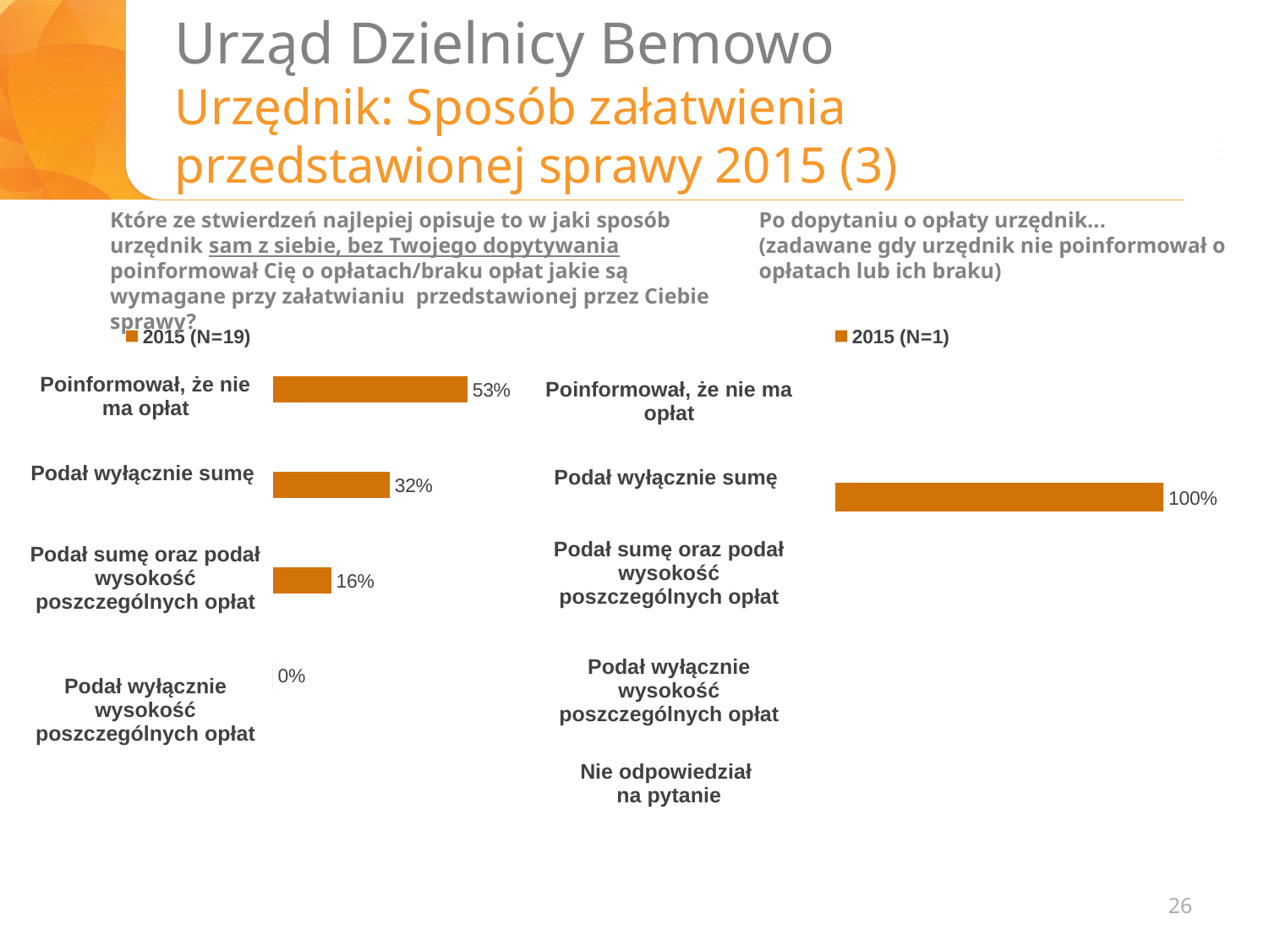
In the left chart (2015, N=19), what percentage is shown for "Podał sumę oraz podał wysokość poszczególnych opłat"? 16% In the left chart (2015, N=19), what percentage is shown for "Podał wyłącznie sumę"? 32% How many categories does the left chart (2015, N=19) show? 4 In the right chart (2015, N=1), what percentage is shown for "Podał wyłącznie sumę"? 100% In the left chart (2015, N=19), which category has the highest value? Poinformował, że nie ma opłat In the left chart (2015, N=19), what is the difference between "Poinformował, że nie ma opłat" and "Podał wyłącznie sumę"? 21 percentage points In the left chart (2015, N=19), what percentage is shown for "Poinformował, że nie ma opłat"? 53% In the left chart (2015, N=19), what percentage is shown for "Podał wyłącznie wysokość poszczególnych opłat"? 0% In the left chart (2015, N=19), which category has the lowest value? Podał wyłącznie wysokość poszczególnych opłat How many categories does the right chart (2015, N=1) list? 5 What type of chart is the left chart (2015, N=19)? Bar chart In the left chart (2015, N=19), which is larger: "Podał wyłącznie sumę" or "Podał sumę oraz podał wysokość poszczególnych opłat"? Podał wyłącznie sumę